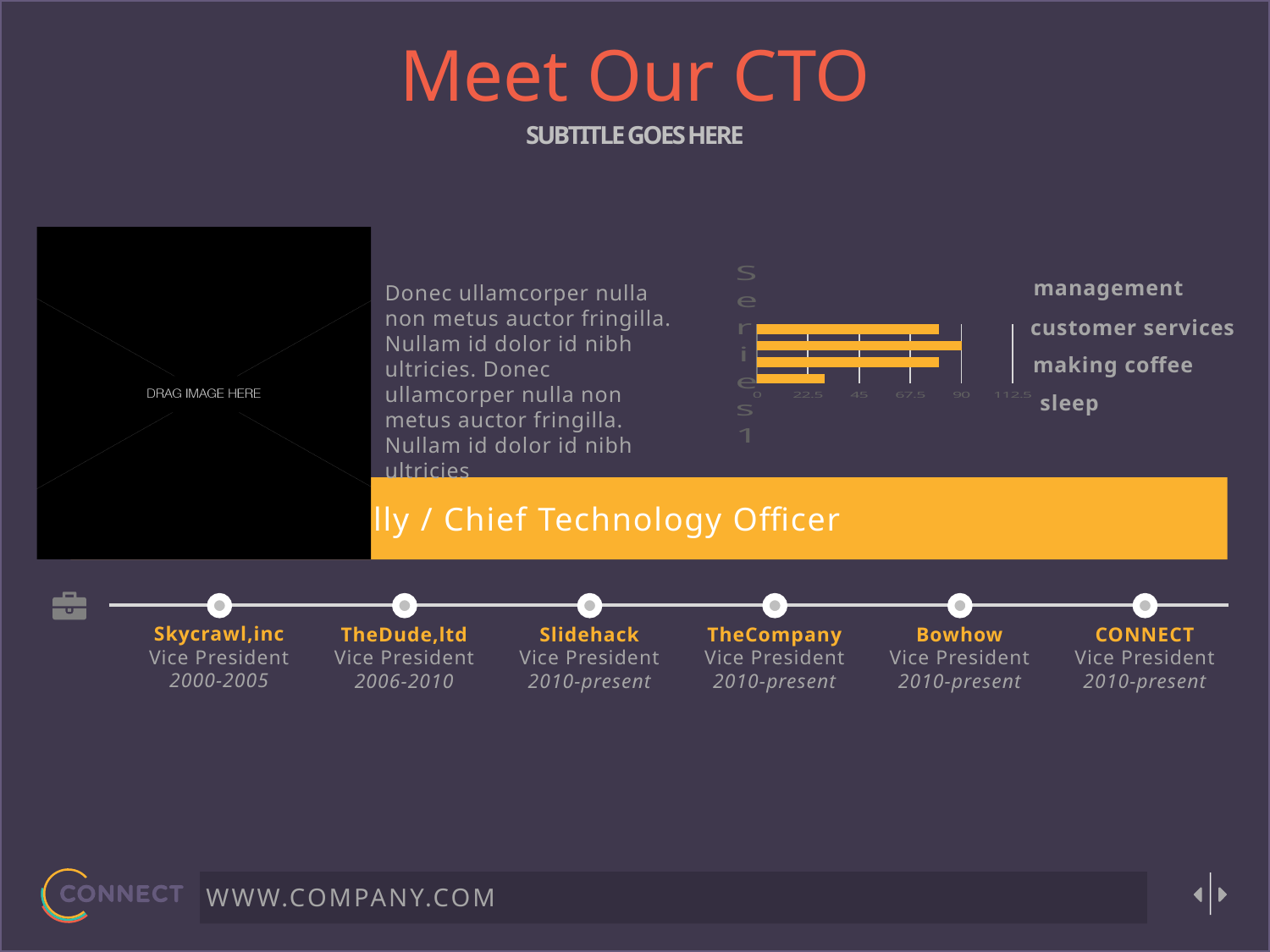
What kind of chart is shown on the slide? bar chart Is the value of the shortest (bottom) bar greater or less than 45? less Is the value of the second bar from the top greater or less than 22.5? greater Is the value of the longest bar greater or less than 67.5? greater What is the lowest tick value shown on the chart's horizontal axis? 0 How many bars does the chart show? 4 Which bar is the shortest: the top bar or the bottom bar? the bottom bar Which is longer: the second bar from the top or the bottom bar? the second bar from the top Which category label is listed last (at the bottom) next to the chart? sleep What is the highest tick value shown on the chart's horizontal axis? 112.5